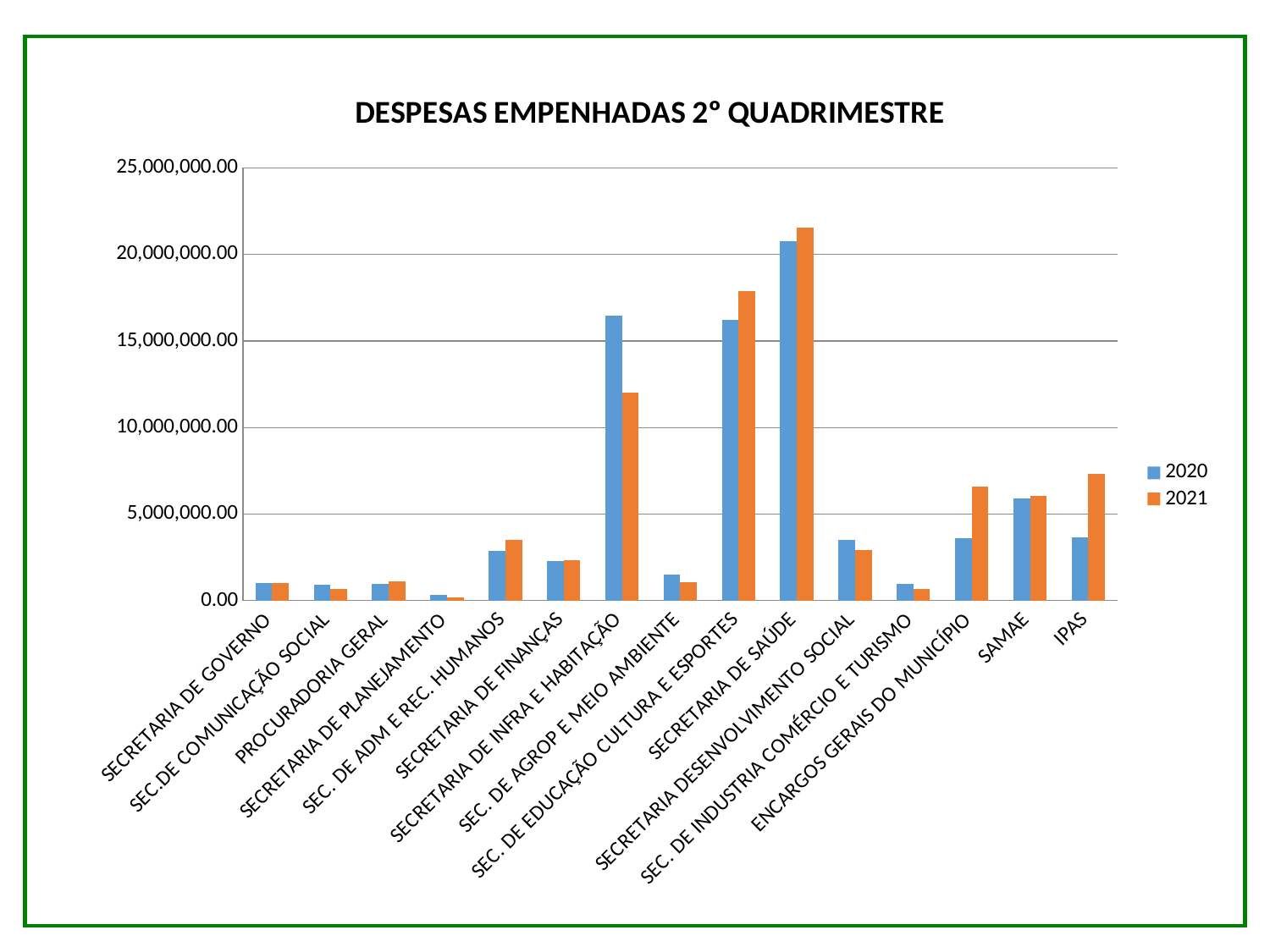
Which category has the highest value for 2021? SECRETARIA DE SAÚDE Is the 2021 value for IPAS greater or less than 5,000,000.00? greater What is the title of the chart? DESPESAS EMPENHADAS 2° QUADRIMESTRE How many series does the legend list? 2 What kind of chart is shown on the slide? Bar chart For SEC. DE EDUCAÇÃO CULTURA E ESPORTES, which year has the larger value, 2020 or 2021? 2021 For SECRETARIA DE INFRA E HABITAÇÃO, which year has the larger value, 2020 or 2021? 2020 Is the 2020 value for SECRETARIA DE INFRA E HABITAÇÃO greater or less than 15,000,000.00? greater Is the 2021 value for SECRETARIA DE INFRA E HABITAÇÃO greater or less than 15,000,000.00? less Which category has the lowest value for 2020? SECRETARIA DE PLANEJAMENTO How many categories are shown on the x axis? 15